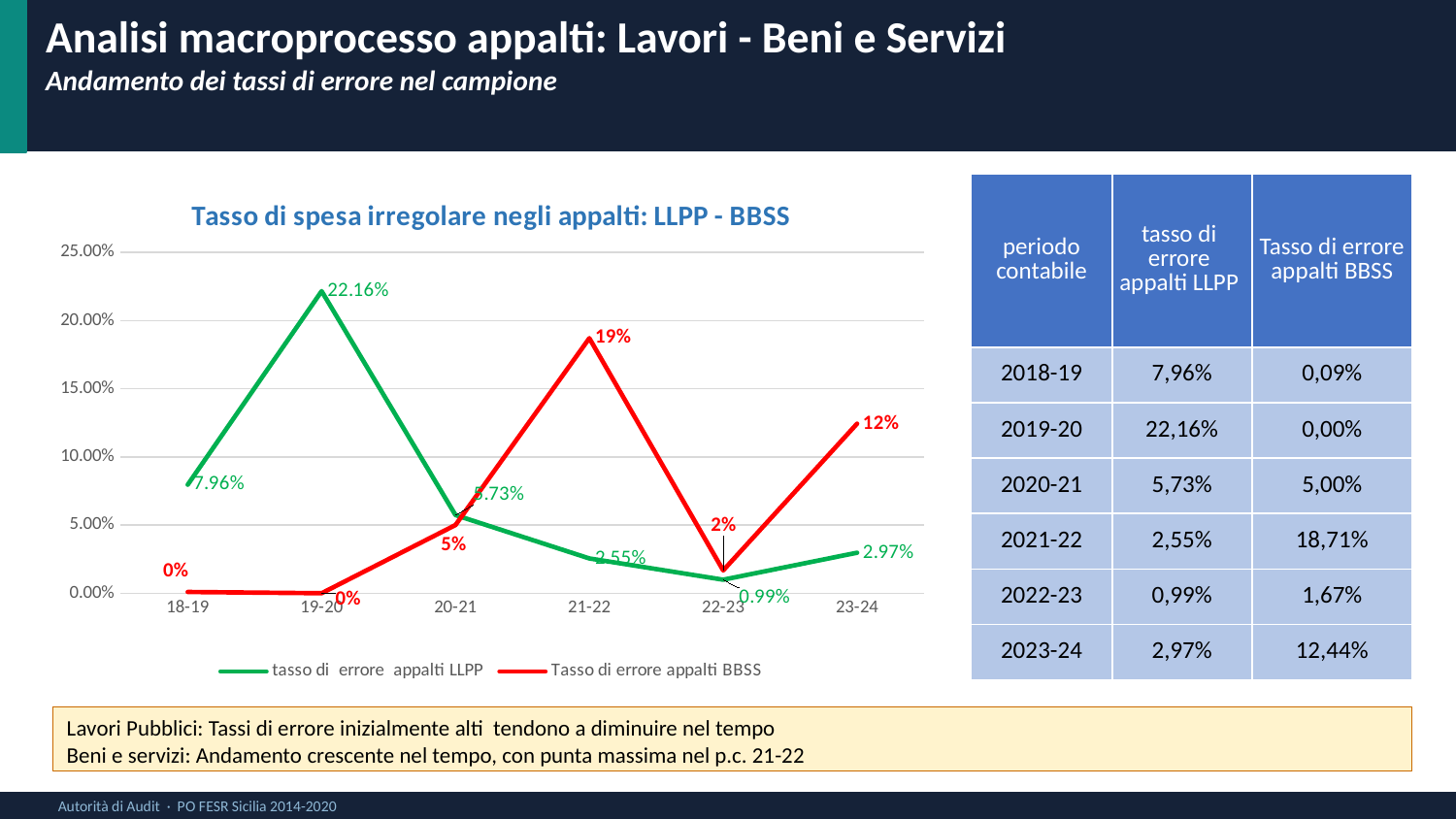
Which series has the larger value in 23-24, LLPP or BBSS? Tasso di errore appalti BBSS How many series does the chart legend list? 2 What is the value of the 'Tasso di errore appalti BBSS' series for 21-22? 19% What type of chart is shown on the slide? Line chart What is the value of the 'tasso di errore appalti LLPP' series for 19-20? 22.16% In which period does the 'tasso di errore appalti LLPP' series reach its lowest value? 22-23 What is the difference between the BBSS value in 21-22 and the BBSS value in 23-24? 7% In which period does the 'Tasso di errore appalti BBSS' series reach its highest value? 21-22 What is the title of the chart? Tasso di spesa irregolare negli appalti: LLPP - BBSS What is the value of the 'tasso di errore appalti LLPP' series for 23-24? 2.97% How many periods are plotted along the x axis of the chart? 6 In which period does the 'tasso di errore appalti LLPP' series reach its highest value? 19-20